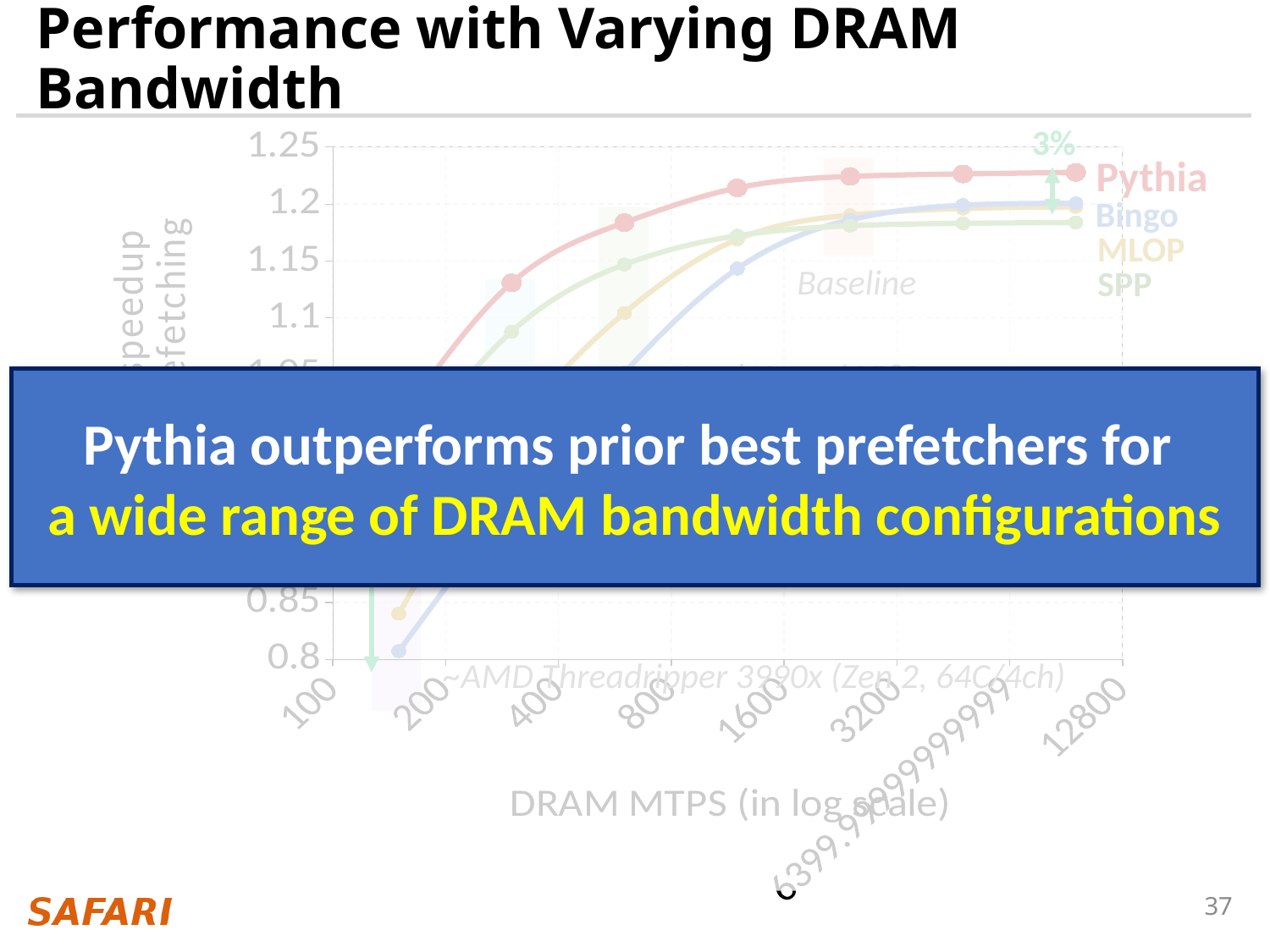
At 12800 DRAM MTPS, which is larger: the value for Pythia or the value for Bingo? Pythia How many series (prefetchers) are plotted in the chart? 4 What percentage is annotated next to the Pythia line at the right edge of the chart? 3% What kind of chart is shown on the slide? line chart Is the value for SPP at 12800 DRAM MTPS greater or less than 1.2? less What is the label of the x axis? DRAM MTPS (in log scale) What is the highest tick value shown on the y axis? 1.25 Does the Pythia line rise or fall as DRAM MTPS increases along the x axis? rises Is the value for Pythia at 12800 DRAM MTPS greater or less than 1.2? greater Is the value for Pythia at 400 DRAM MTPS greater or less than 1.1? greater Which series has the highest speedup at the right end of the x axis (12800 DRAM MTPS)? Pythia